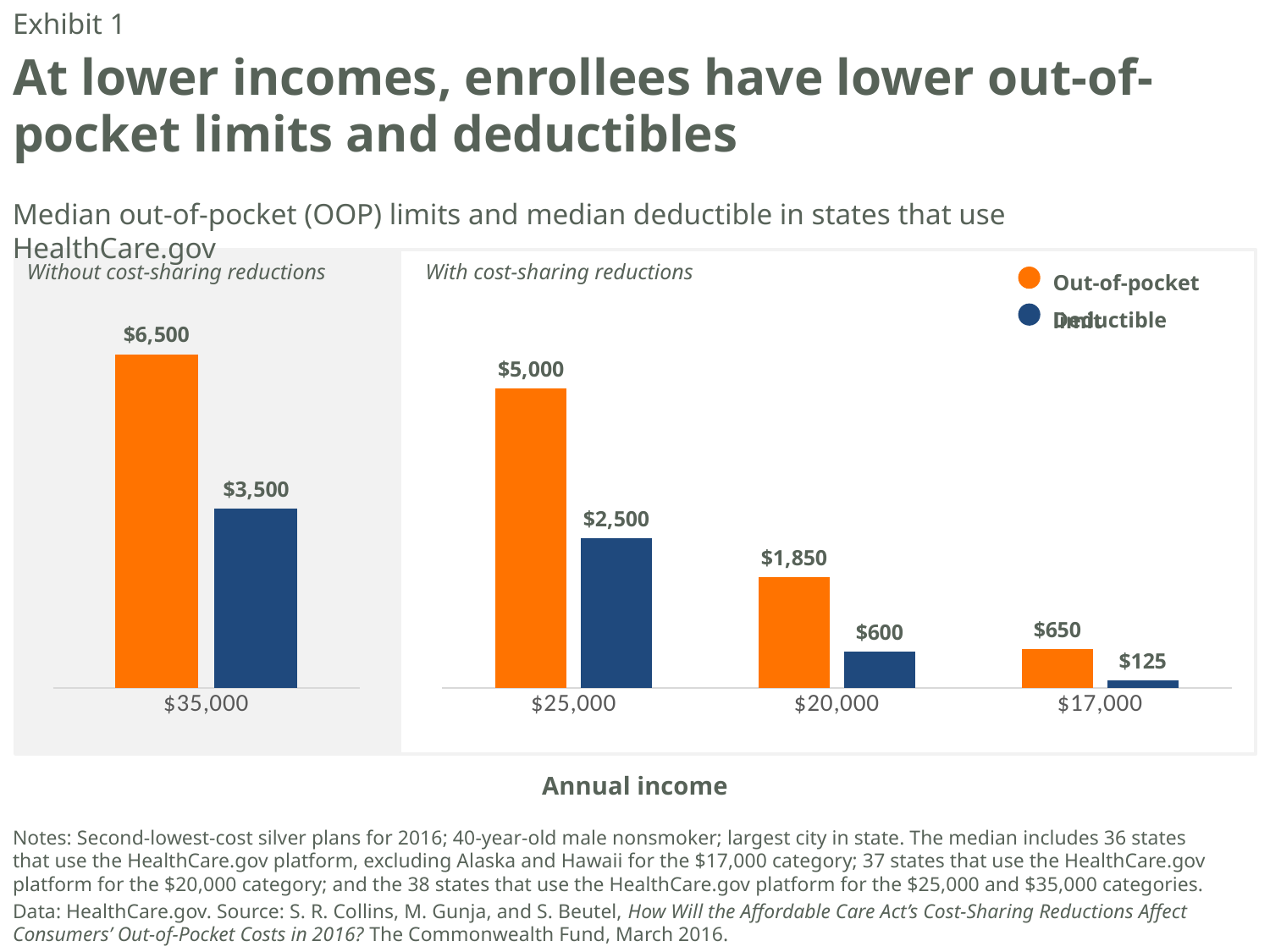
In the 'With cost-sharing reductions' chart, what is the out-of-pocket limit at an annual income of $25,000? $5,000 In the 'With cost-sharing reductions' chart, which is larger: the out-of-pocket limit at $20,000 or the out-of-pocket limit at $17,000? $20,000 In the 'With cost-sharing reductions' chart, which annual income level has the lowest deductible? $17,000 In the 'With cost-sharing reductions' chart, what is the difference between the out-of-pocket limit and the deductible at an annual income of $25,000? $2,500 In the 'Without cost-sharing reductions' chart, what is the deductible at an annual income of $35,000? $3,500 In the 'With cost-sharing reductions' chart, what is the deductible at an annual income of $17,000? $125 How many annual income categories are shown in the 'With cost-sharing reductions' chart? 3 In the 'Without cost-sharing reductions' chart, what is the difference between the out-of-pocket limit and the deductible at $35,000? $3,000 In the 'With cost-sharing reductions' chart, what is the deductible at an annual income of $20,000? $600 In the 'With cost-sharing reductions' chart, which annual income level has the highest out-of-pocket limit? $25,000 What type of chart is used on this slide? Bar chart In the 'Without cost-sharing reductions' chart, what is the out-of-pocket limit at an annual income of $35,000? $6,500